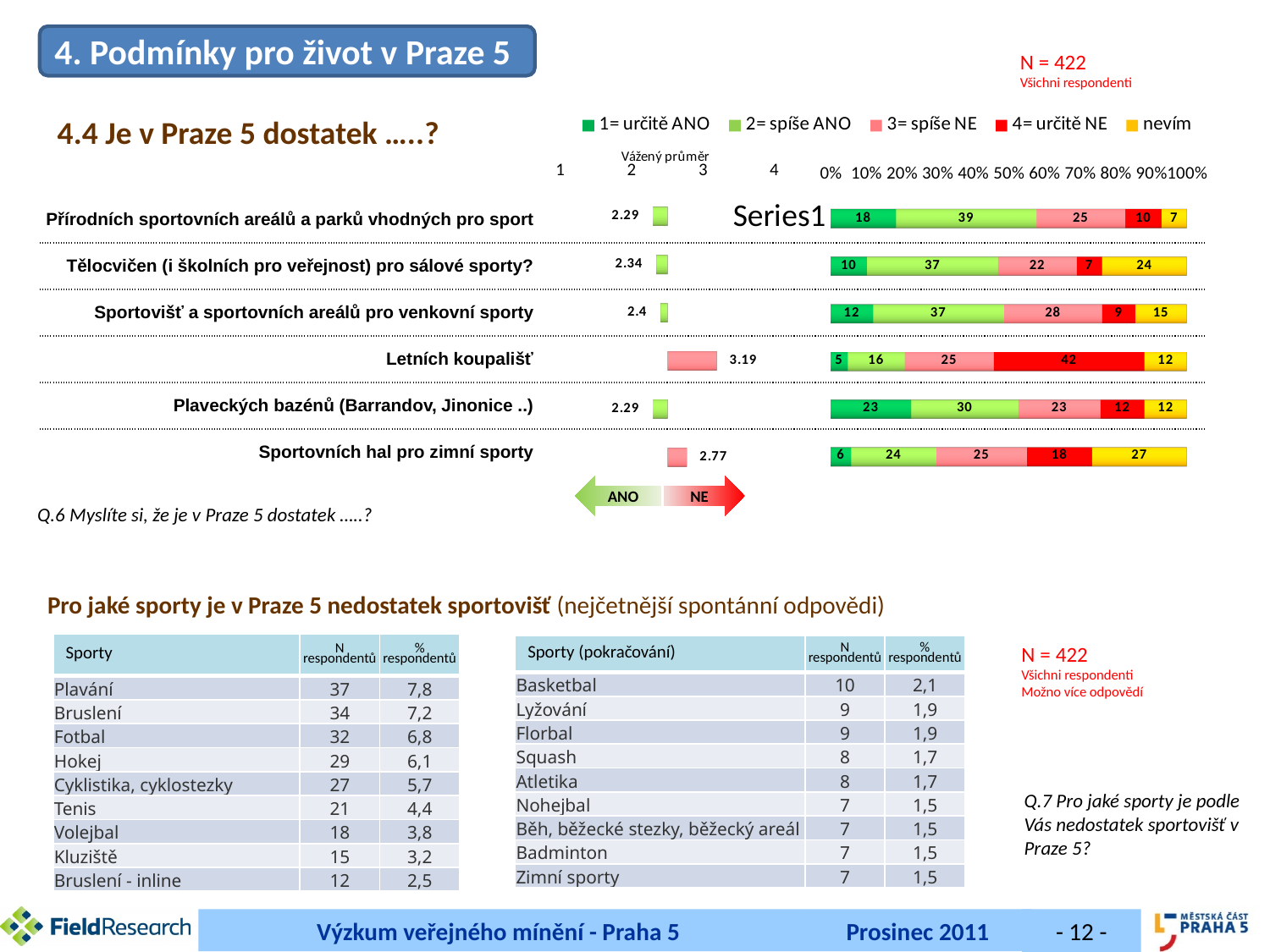
In the stacked bar chart, what is the value of "4= určitě NE" for "Letních koupališť"? 42 In the stacked bar chart, what is the total of the stacked bar for "Tělocvičen (i školních pro veřejnost) pro sálové sporty?"? 100 In the "Vážený průměr" chart, which category has the highest weighted average? Letních koupališť In the stacked bar chart legend, what colour represents "4= určitě NE"? Red In the "Vážený průměr" (weighted average) chart, what is the value for "Sportovních hal pro zimní sporty"? 2.77 In the stacked bar chart, which category has the lowest value for "1= určitě ANO"? Letních koupališť What kind of chart is used to show the answer distribution on the right side of the slide? Stacked bar chart In the stacked bar chart, what is the value of "1= určitě ANO" for "Plaveckých bazénů (Barrandov, Jinonice ..)"? 23 In the stacked bar chart, which has the larger "nevím" value: "Tělocvičen (i školních pro veřejnost) pro sálové sporty?" or "Sportovních hal pro zimní sporty"? Sportovních hal pro zimní sporty How many series does the legend of the stacked bar chart list? 5 How many categories (rows) does the stacked bar chart show? 6 In the stacked bar chart, what is the difference between the "2= spíše ANO" values for "Přírodních sportovních areálů a parků vhodných pro sport" and "Letních koupališť"? 23